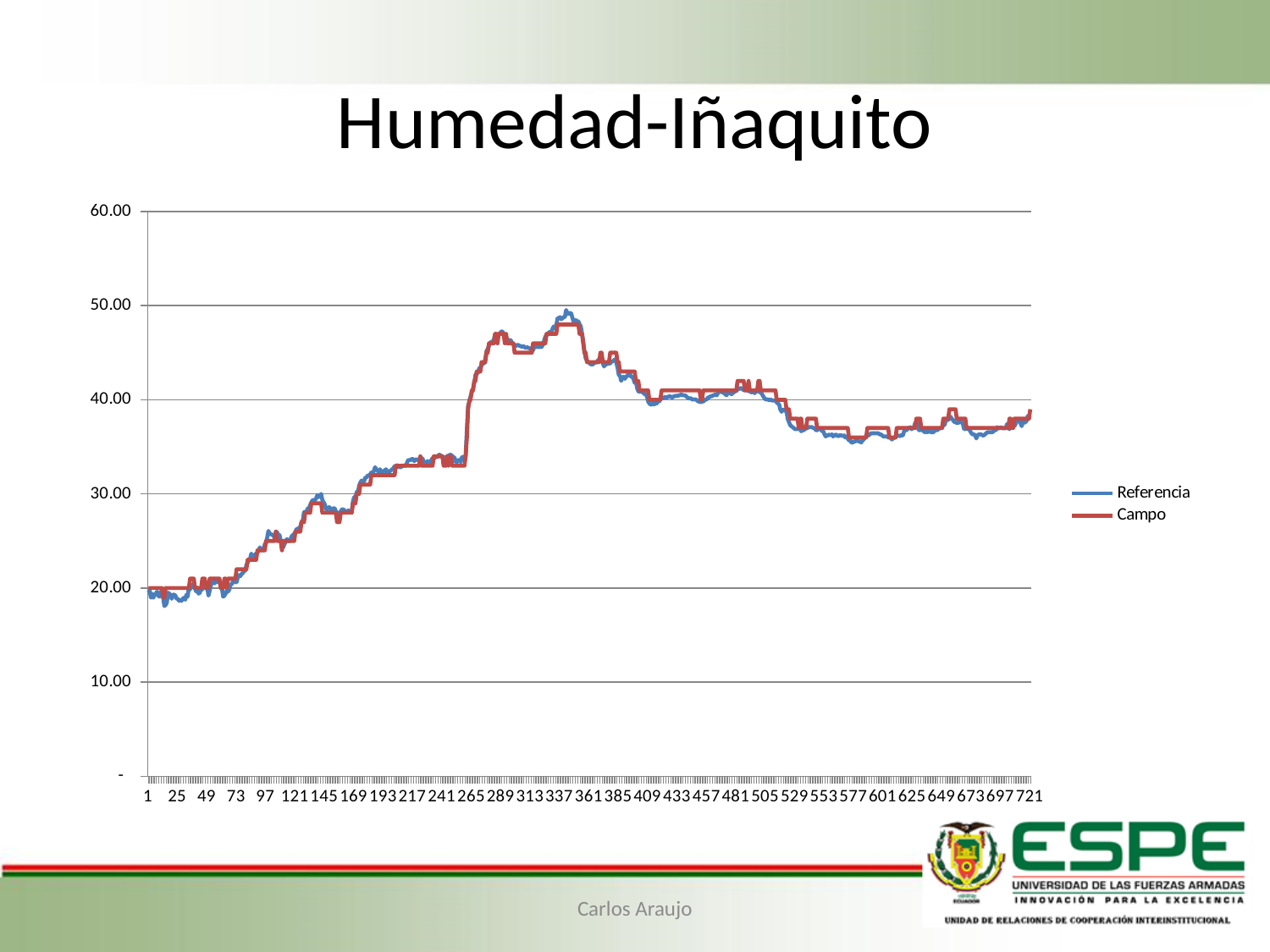
Is the value of the Campo series at x = 721 greater or less than 30.00? greater Do the series values rise or fall between x = 337 and x = 553? fall Is the value of the Campo series at x = 241 greater or less than 30.00? greater How many series does the legend list? 2 Around which x-axis label does the Referencia series reach its highest value? 337 Do the series values rise or fall between x = 1 and x = 289? rise Is the value of the Referencia series at x = 601 greater or less than 40.00? less Which series is drawn in red? Campo What kind of chart is shown on the slide? line chart What is the title of the chart? Humedad-Iñaquito